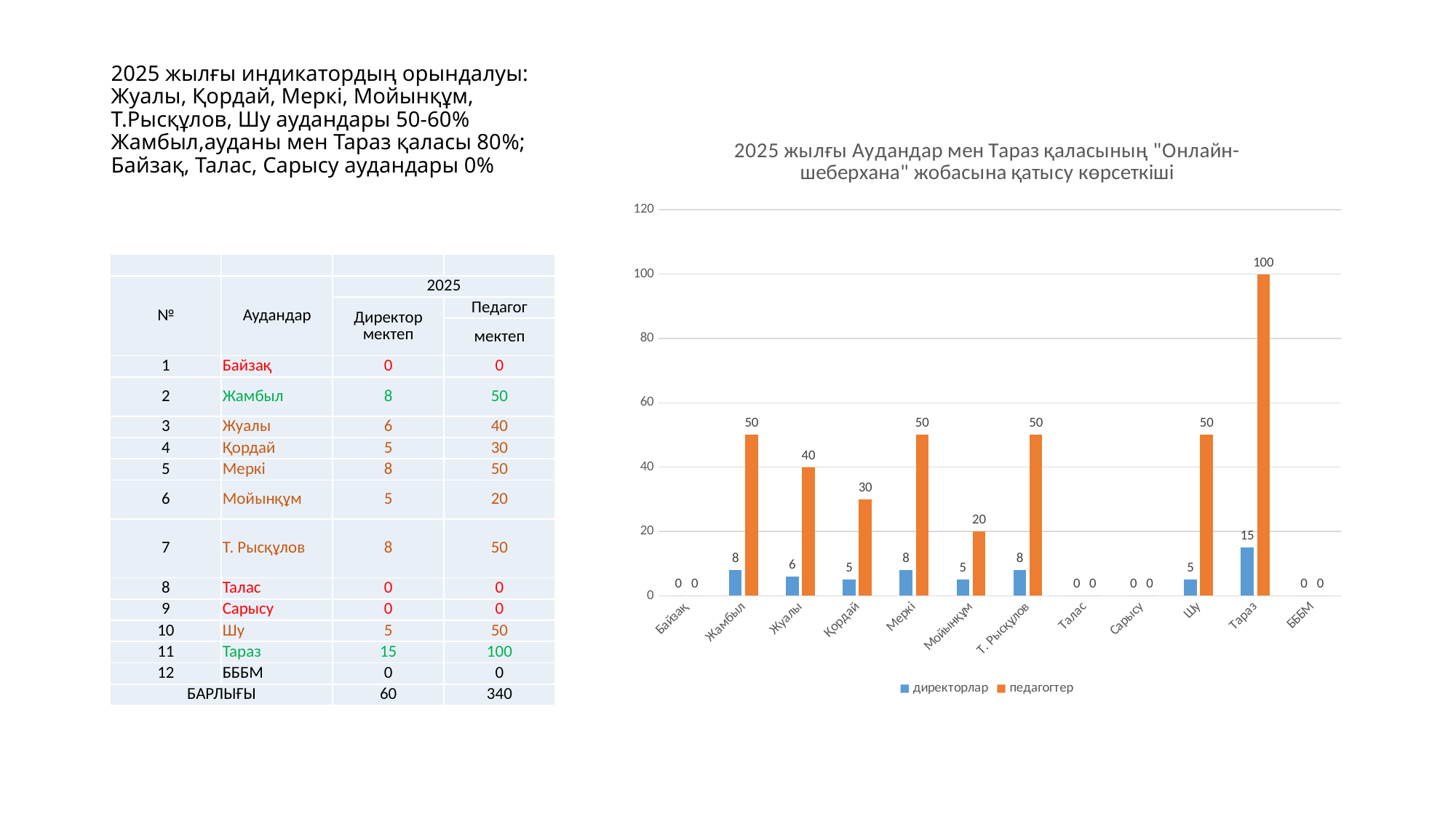
What colour are the педагогтер bars? orange Is the педагогтер value for Тараз greater or less than 80? greater Which category has the highest директорлар value? Тараз Which category has the highest педагогтер value? Тараз What is the value for директорлар in Жуалы? 6 How many categories are shown on the x axis? 12 What is the difference between the педагогтер values for Тараз and Жамбыл? 50 Which is larger, the педагогтер value for Жуалы or for Қордай? Жуалы What is the value for педагогтер in Мойынқұм? 20 How many series does the legend list? 2 What is the value for педагогтер in Тараз? 100 What kind of chart is shown? bar chart